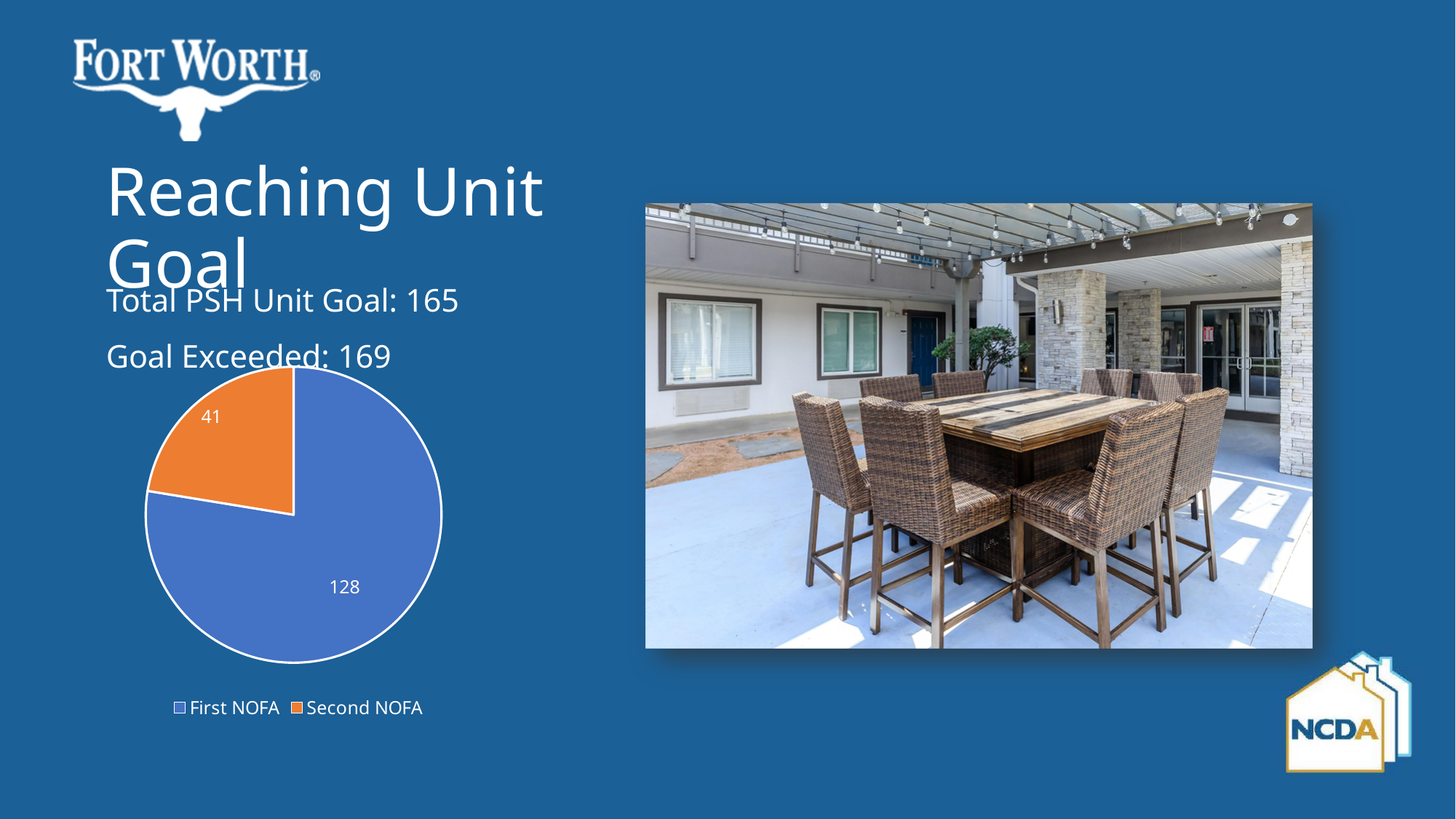
What is the value for First NOFA? 128 What is the difference between the First NOFA and Second NOFA values? 87 How many entries does the legend list? 2 Which slice is the smallest? Second NOFA Which slice is the largest? First NOFA What kind of chart is shown on the slide? pie chart What colour is the Second NOFA slice? orange Which is larger, First NOFA or Second NOFA? First NOFA How many slices does the pie chart have? 2 Where is the legend positioned relative to the pie chart? below the chart What is the total of the two slices in the pie chart? 169 What is the value for Second NOFA? 41